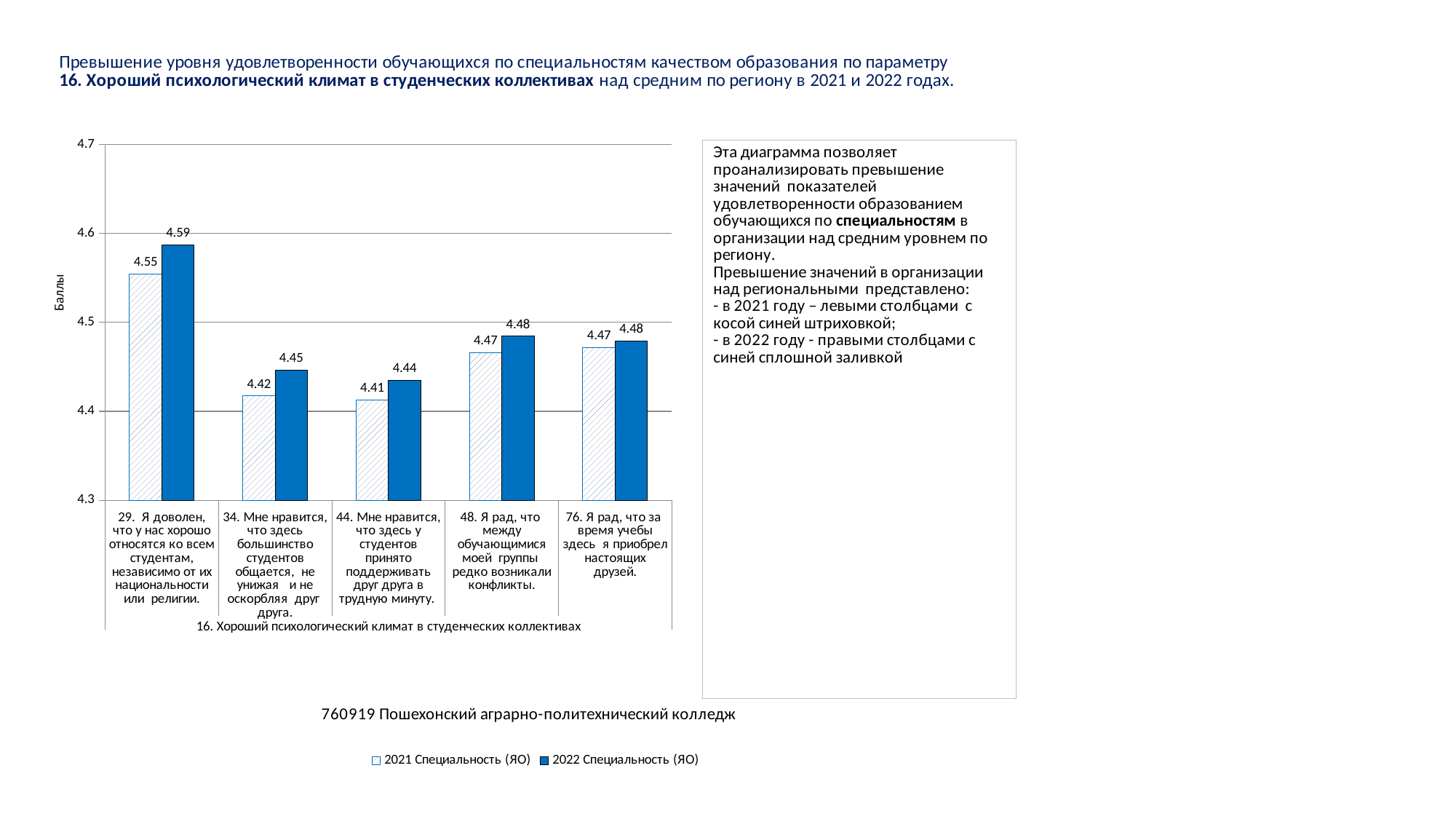
What is the 2021 Специальность (ЯО) value for statement 34 (Мне нравится, что здесь большинство студентов общается, не унижая и не оскорбляя друг друга)? 4.42 Which statement has the highest 2022 Специальность (ЯО) value? 29. Я доволен, что у нас хорошо относятся ко всем студентам, независимо от их национальности или религии. What type of chart is shown on the slide? bar chart What is the label of the y axis? Баллы What is the 2022 Специальность (ЯО) value for statement 29 (Я доволен, что у нас хорошо относятся ко всем студентам)? 4.59 How many categories (statements) are plotted on the x axis? 5 How many series does the legend list? 2 Which statement has the lowest 2021 Специальность (ЯО) value? 44. Мне нравится, что здесь у студентов принято поддерживать друг друга в трудную минуту. Is the 2021 value for statement 29 greater or less than 4.5? greater What is the difference between the 2022 and 2021 values for statement 29? 0.04 Which is larger for statement 34: the 2021 value or the 2022 value? 2022 value What is the 2021 Специальность (ЯО) value for statement 44 (Мне нравится, что здесь у студентов принято поддерживать друг друга)? 4.41